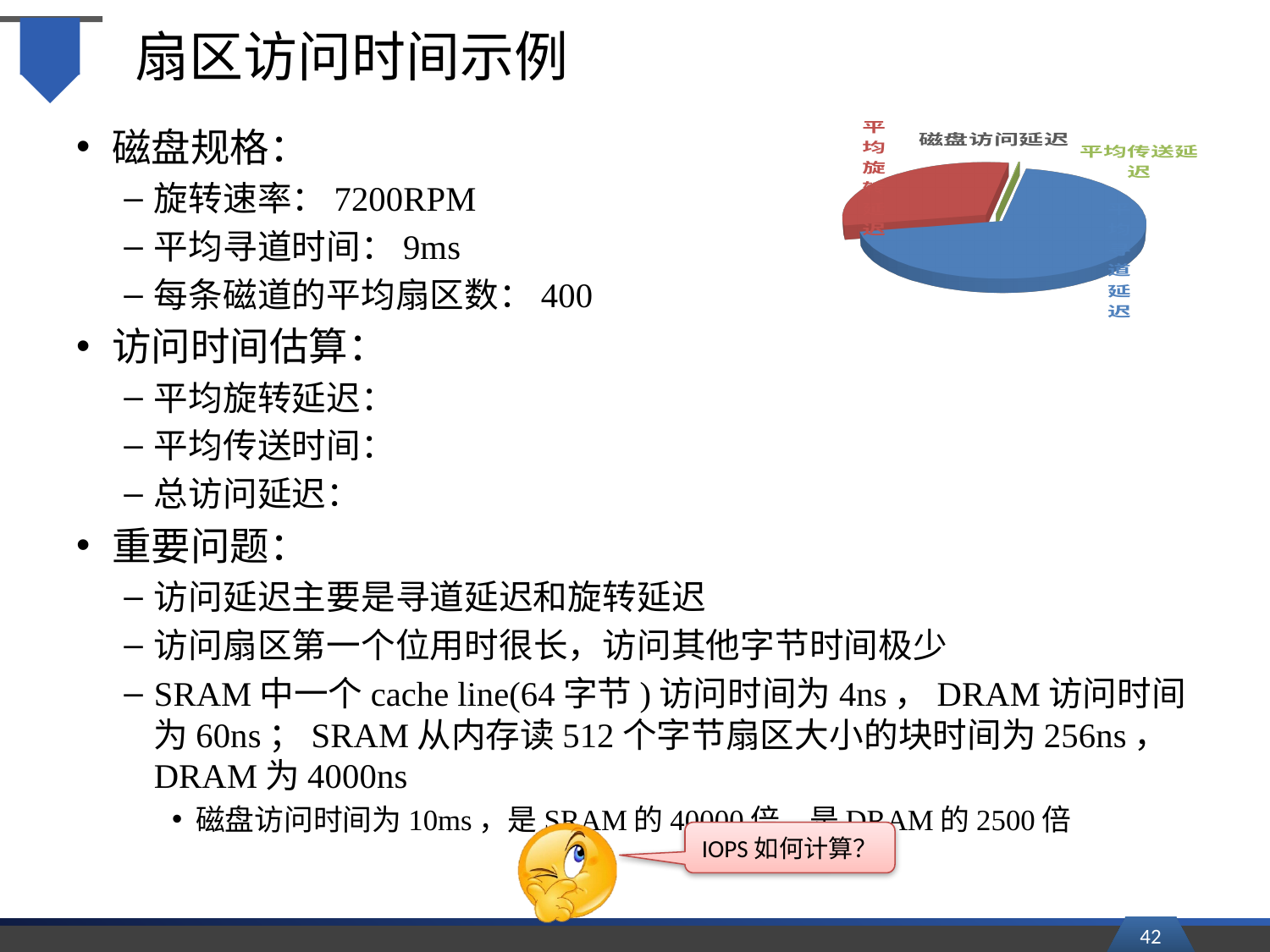
Does the 平均传送延迟 slice take up more or less than half of the pie? less What kind of chart is shown on the slide? pie chart How many slices does the pie chart have? 3 Which slice of the pie chart is the smallest? 平均传送延迟 Is the slice for 平均传送延迟 larger or smaller than the red slice? smaller What is the title of the chart on the slide? 磁盘访问延迟 Which colour is the largest slice of the pie chart? blue Is the blue slice larger or smaller than the red slice? larger